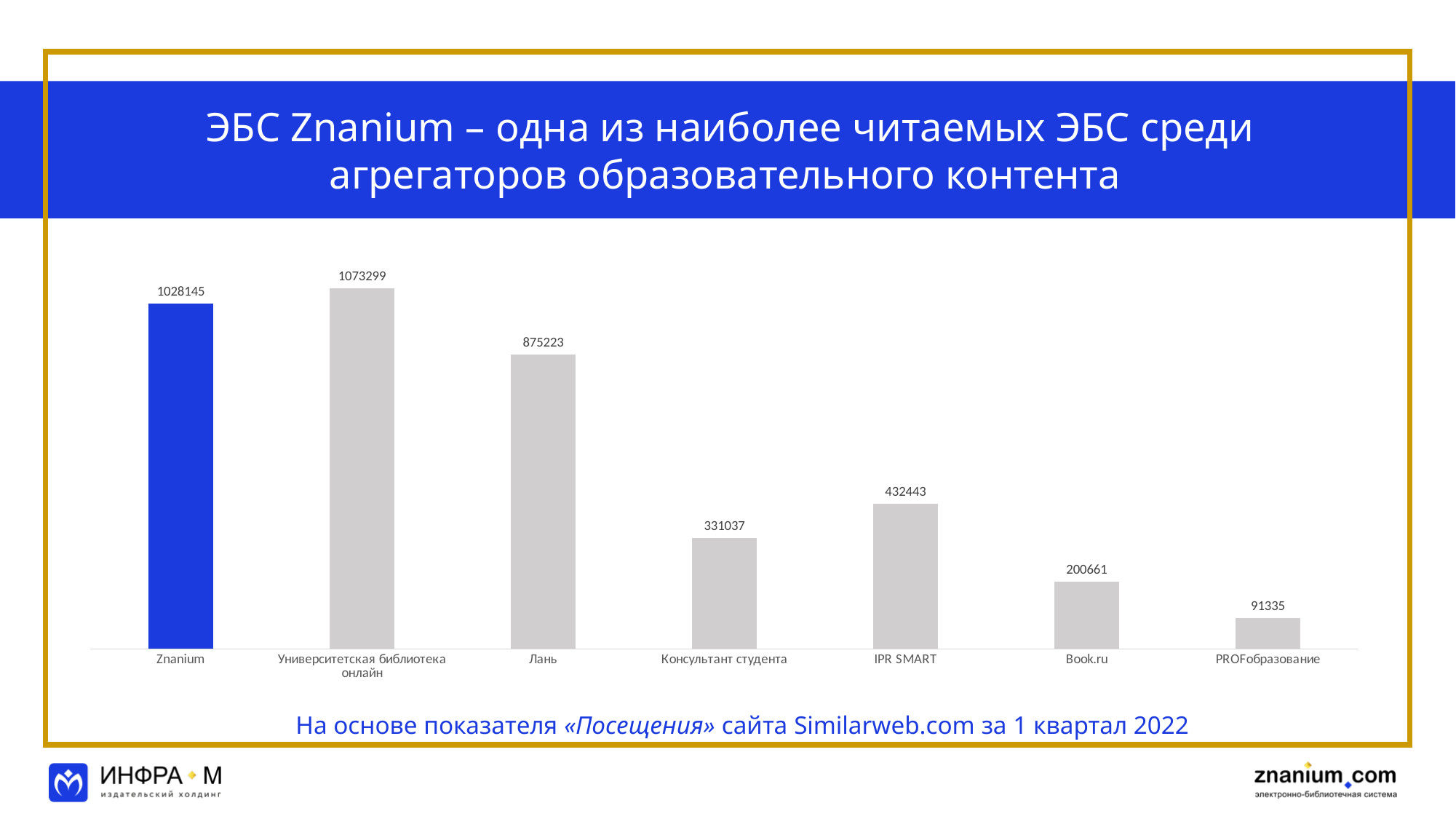
Which category's bar is coloured blue rather than grey? Znanium What is the difference between the values for IPR SMART and Консультант студента? 101406 What is the value for Лань? 875223 How many categories are shown in the chart? 7 Which is larger, the value for Консультант студента or the value for IPR SMART? IPR SMART Which category has the highest value? Университетская библиотека онлайн What is the value for Znanium? 1028145 What kind of chart is shown on the slide? Bar chart What is the value for Book.ru? 200661 Which category has the lowest value? PROFобразование What is the value for IPR SMART? 432443 What is the difference between the values for Университетская библиотека онлайн and Znanium? 45154